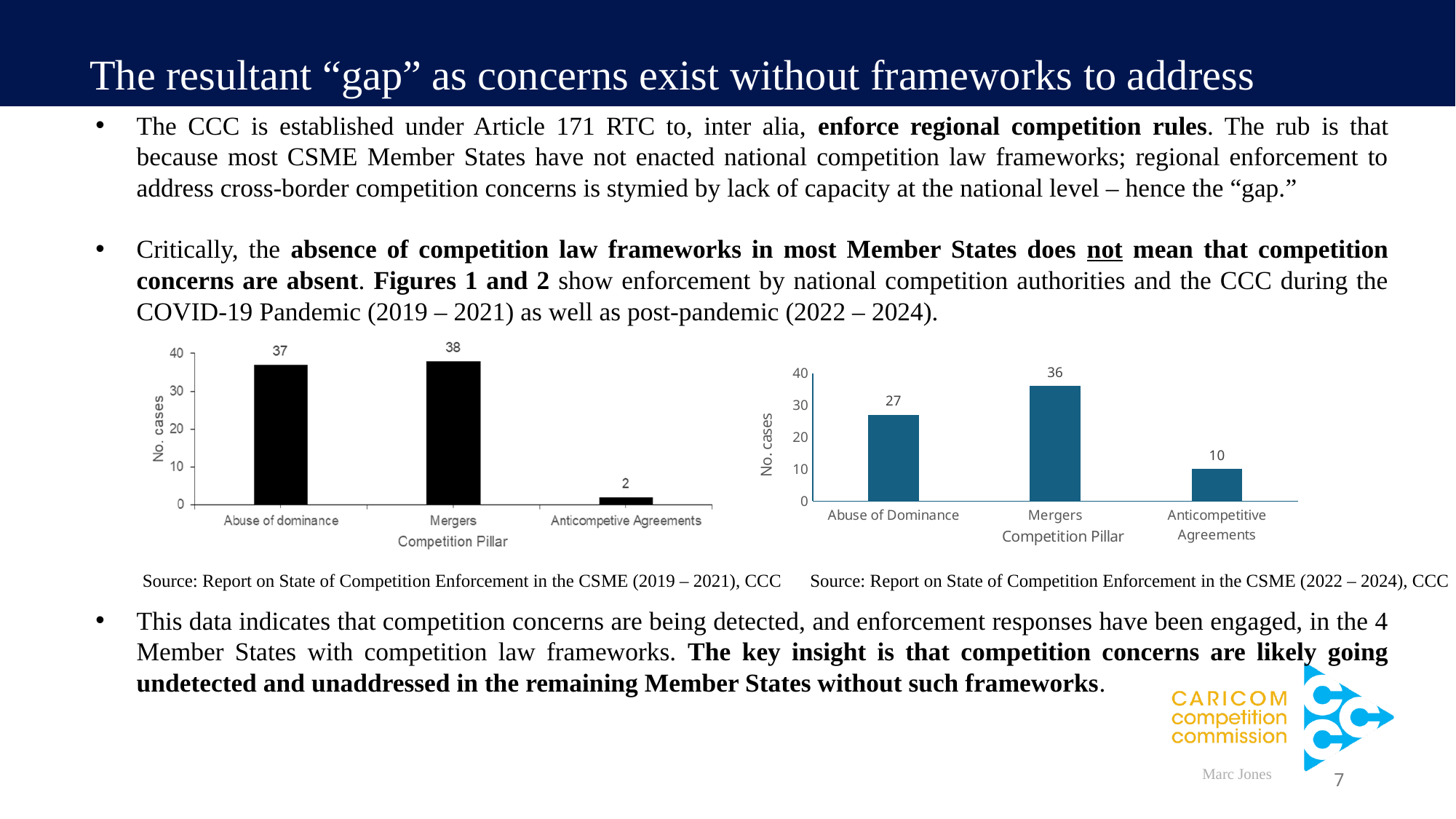
In the right chart, how many cases are shown for Abuse of Dominance? 27 What is the y-axis label of the right chart? No. cases How many competition pillars are shown on the x axis of the right chart? 3 In the right chart, how many cases are shown for Anticompetitive Agreements? 10 In the right chart, what is the difference in cases between Mergers and Abuse of Dominance? 9 In the left chart, how many cases are shown for Abuse of dominance? 37 Which chart shows more Anticompetitive Agreements cases, the left chart or the right chart? the right chart In the left chart, which competition pillar has the lowest number of cases? Anticompetive Agreements In the left chart, what is the difference in cases between Mergers and Anticompetive Agreements? 36 In the right chart, which competition pillar has the highest number of cases? Mergers What type of chart is the left chart? bar chart In the left chart, how many cases are shown for Mergers? 38